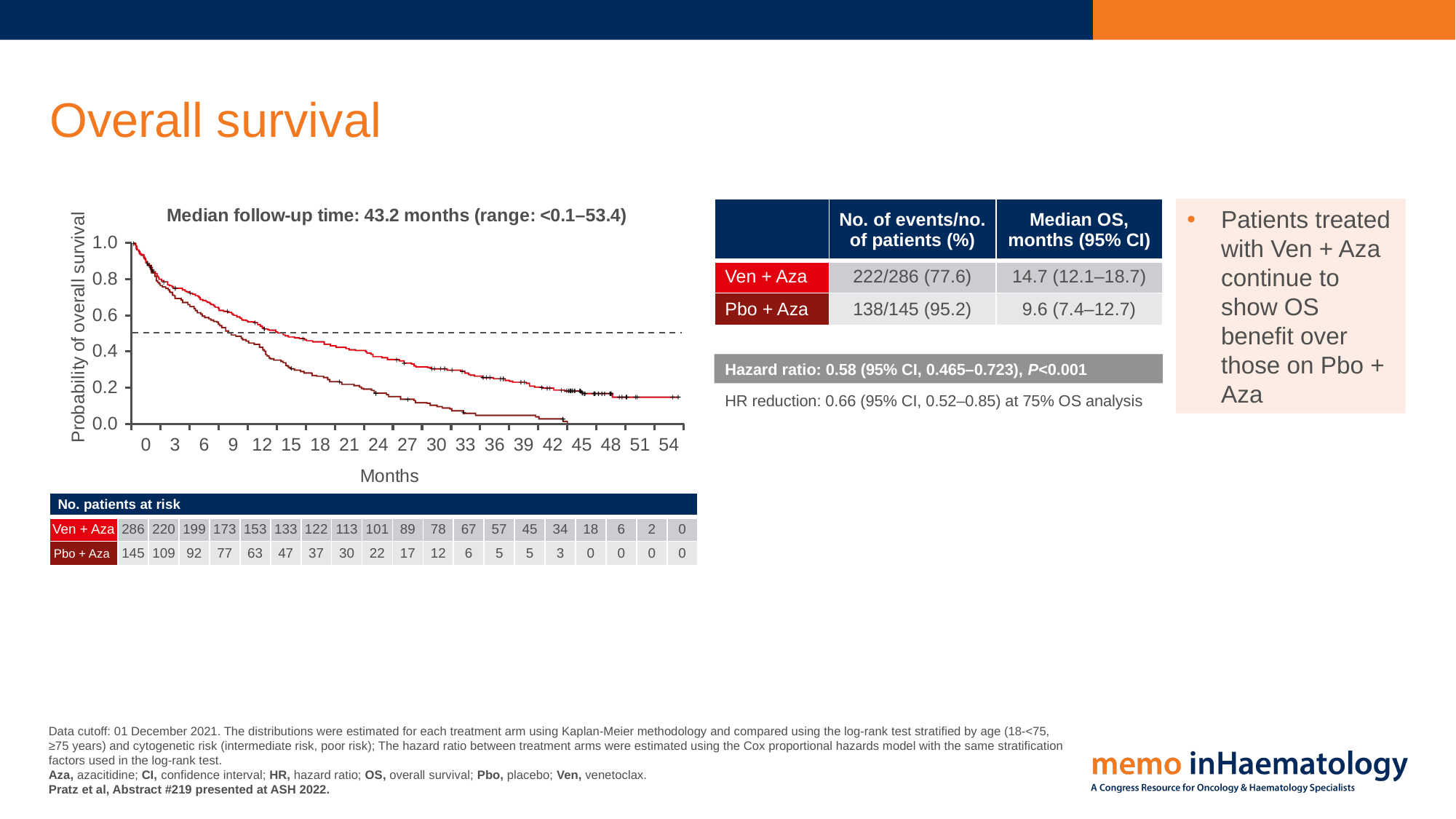
At month 24, which arm had more patients at risk, Ven + Aza or Pbo + Aza? Ven + Aza What is the label of the y axis of the survival chart? Probability of overall survival What is the difference in the number of patients at risk at month 0 between Ven + Aza and Pbo + Aza? 141 Is the probability of overall survival for Pbo + Aza at 36 months greater or less than 0.2? less How many patients were at risk in the Ven + Aza arm at month 0? 286 How many patients were at risk in the Ven + Aza arm at month 36? 57 Is the probability of overall survival for Ven + Aza at 6 months greater or less than 0.6? greater Do the survival curves rise or fall as months increase? Fall What kind of chart is shown on the slide? Line chart (Kaplan-Meier survival curve) How many treatment arms are plotted on the survival chart? 2 What median follow-up time is stated in the chart title? 43.2 months How many patients were at risk in the Pbo + Aza arm at month 12? 63